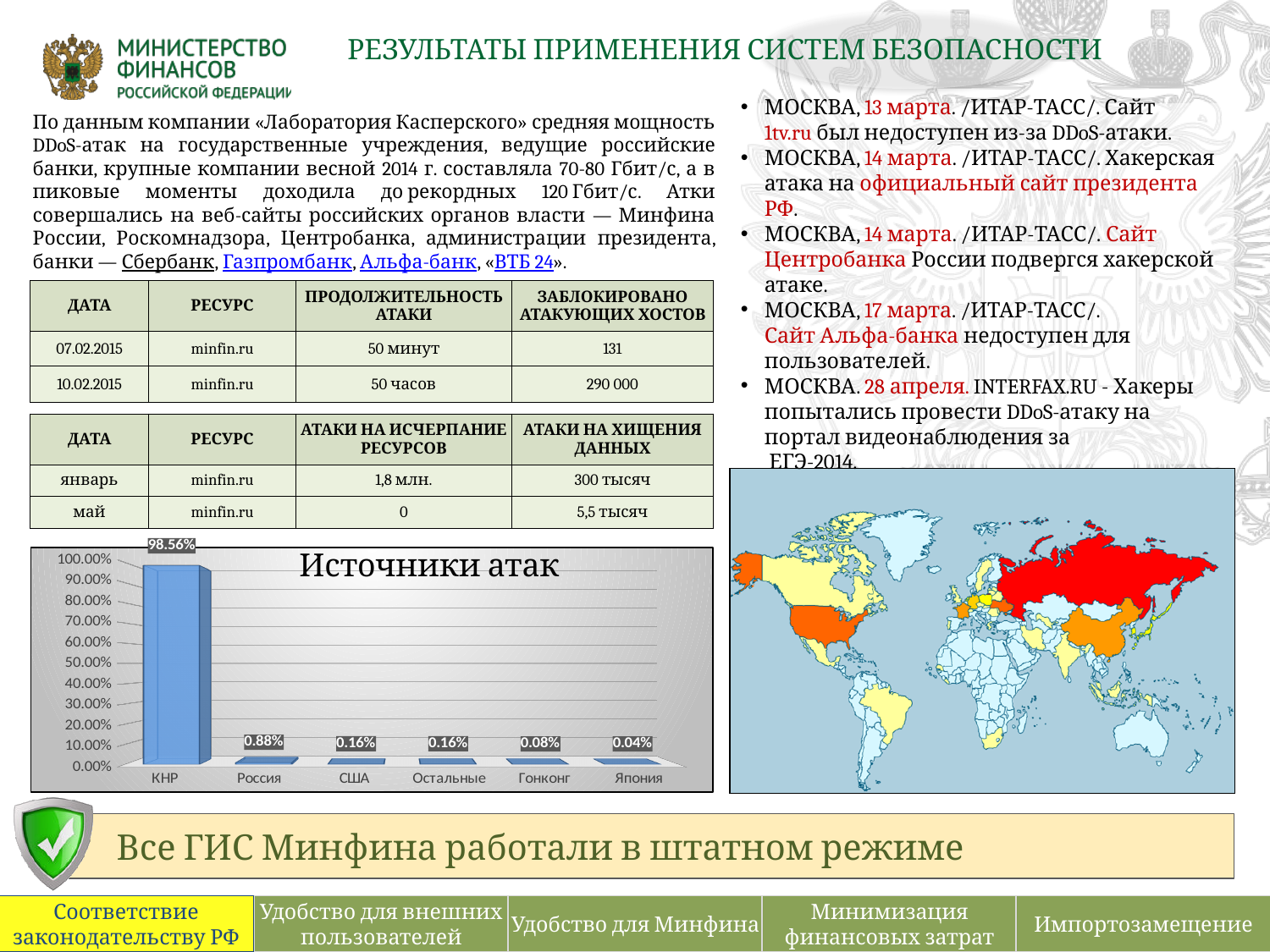
How many categories are shown in the Источники атак chart? 6 What is the value for Гонконг in the Источники атак chart? 0.08% What is the value for Япония in the Источники атак chart? 0.04% What is the value for КНР in the Источники атак chart? 98.56% What kind of chart is the Источники атак chart? bar chart Which is larger in the Источники атак chart, the value for Россия or the value for Гонконг? Россия What is the difference between the values for КНР and Россия in the Источники атак chart? 97.68% Which category has the highest value in the Источники атак chart? КНР Which category has the lowest value in the Источники атак chart? Япония Is the value for КНР in the Источники атак chart greater or less than 90.00%? greater What is the value for Россия in the Источники атак chart? 0.88% What is the difference between the values for Россия and США in the Источники атак chart? 0.72%